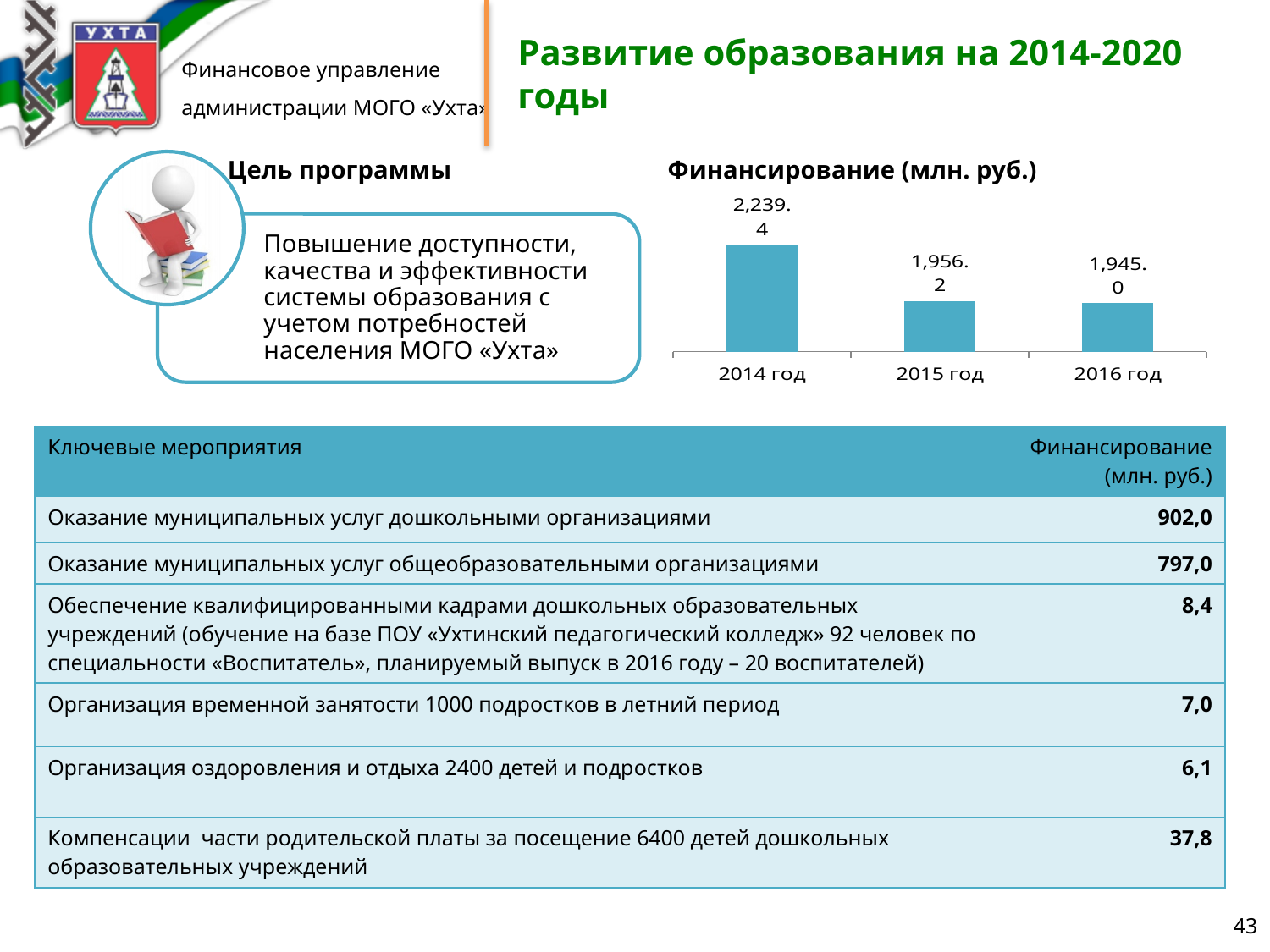
In the Финансирование (млн. руб.) chart, which is larger: the value for 2015 год or 2016 год? 2015 год How many years are shown in the Финансирование (млн. руб.) chart? 3 What is the value for 2016 год in the Финансирование (млн. руб.) chart? 1,945.0 What kind of chart is the Финансирование (млн. руб.) chart? bar chart Which year has the lowest value in the Финансирование (млн. руб.) chart? 2016 год What is the difference between the values for 2015 год and 2016 год in the Финансирование (млн. руб.) chart? 11.2 What is the difference between the values for 2014 год and 2016 год in the Финансирование (млн. руб.) chart? 294.4 What is the value for 2014 год in the Финансирование (млн. руб.) chart? 2,239.4 What is the value for 2015 год in the Финансирование (млн. руб.) chart? 1,956.2 Do the values in the Финансирование (млн. руб.) chart rise or fall from 2014 год to 2016 год? fall What is the difference between the values for 2014 год and 2015 год in the Финансирование (млн. руб.) chart? 283.2 Which year has the highest value in the Финансирование (млн. руб.) chart? 2014 год